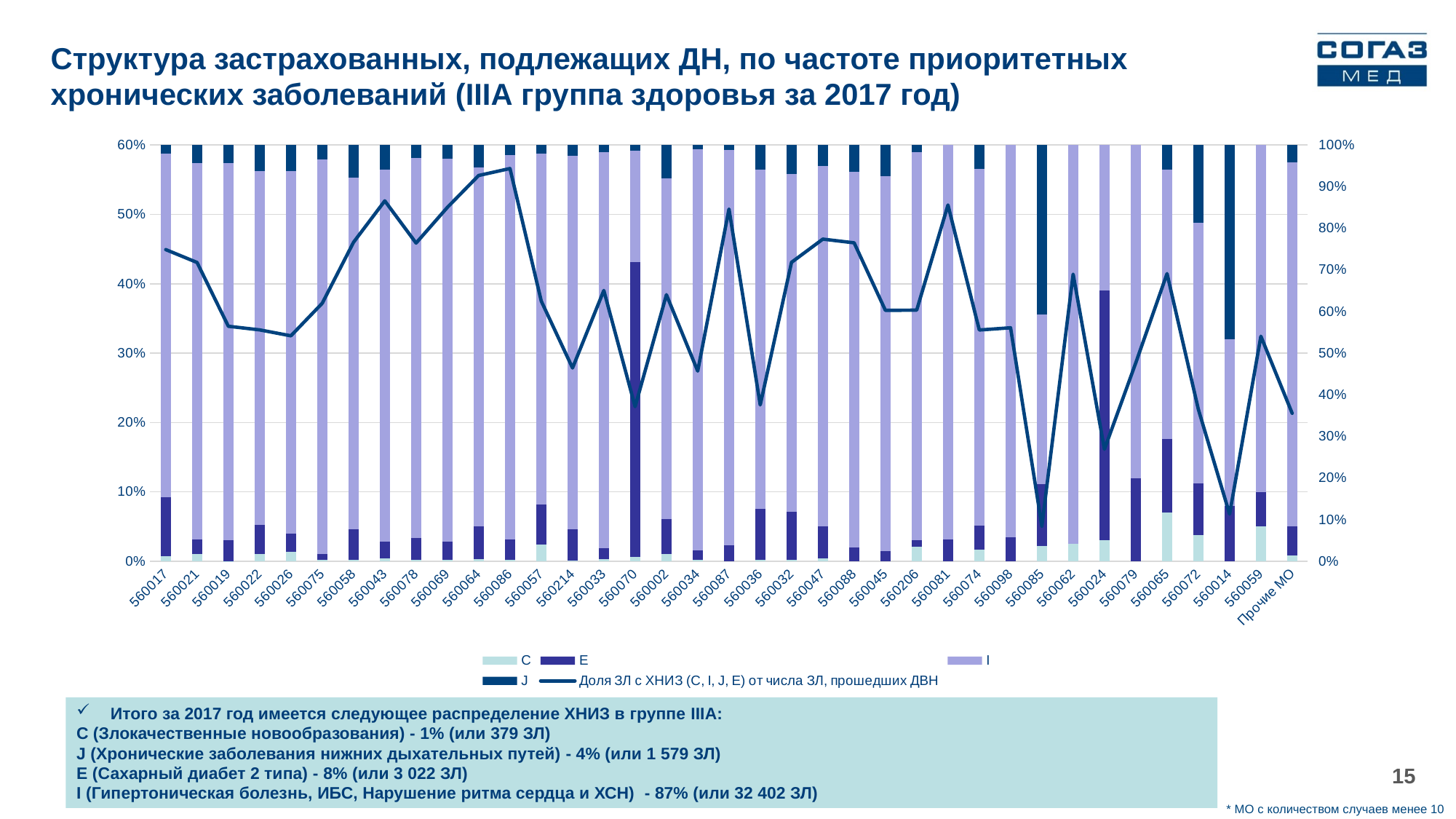
Which category has the largest J (dark blue) segment in its bar? 560014 How many series does the legend list? 5 Is the line value (Доля ЗЛ с ХНИЗ) for 560017 greater or less than 40%? greater What is the name of the line series in the legend? Доля ЗЛ с ХНИЗ (C, I, J, E) от числа ЗЛ, прошедших ДВН Which has the higher line value (Доля ЗЛ с ХНИЗ): 560017 or 560019? 560017 Is the line value (Доля ЗЛ с ХНИЗ) for 560086 greater or less than 50%? greater Is the line value (Доля ЗЛ с ХНИЗ) for 560070 greater or less than 30%? less Which has the higher line value (Доля ЗЛ с ХНИЗ): 560087 or 560036? 560087 Which category has the largest E (dark purple) segment in its bar? 560070 How many categories are shown along the x axis? 37 What kind of chart is shown on the slide? A stacked bar chart combined with a line